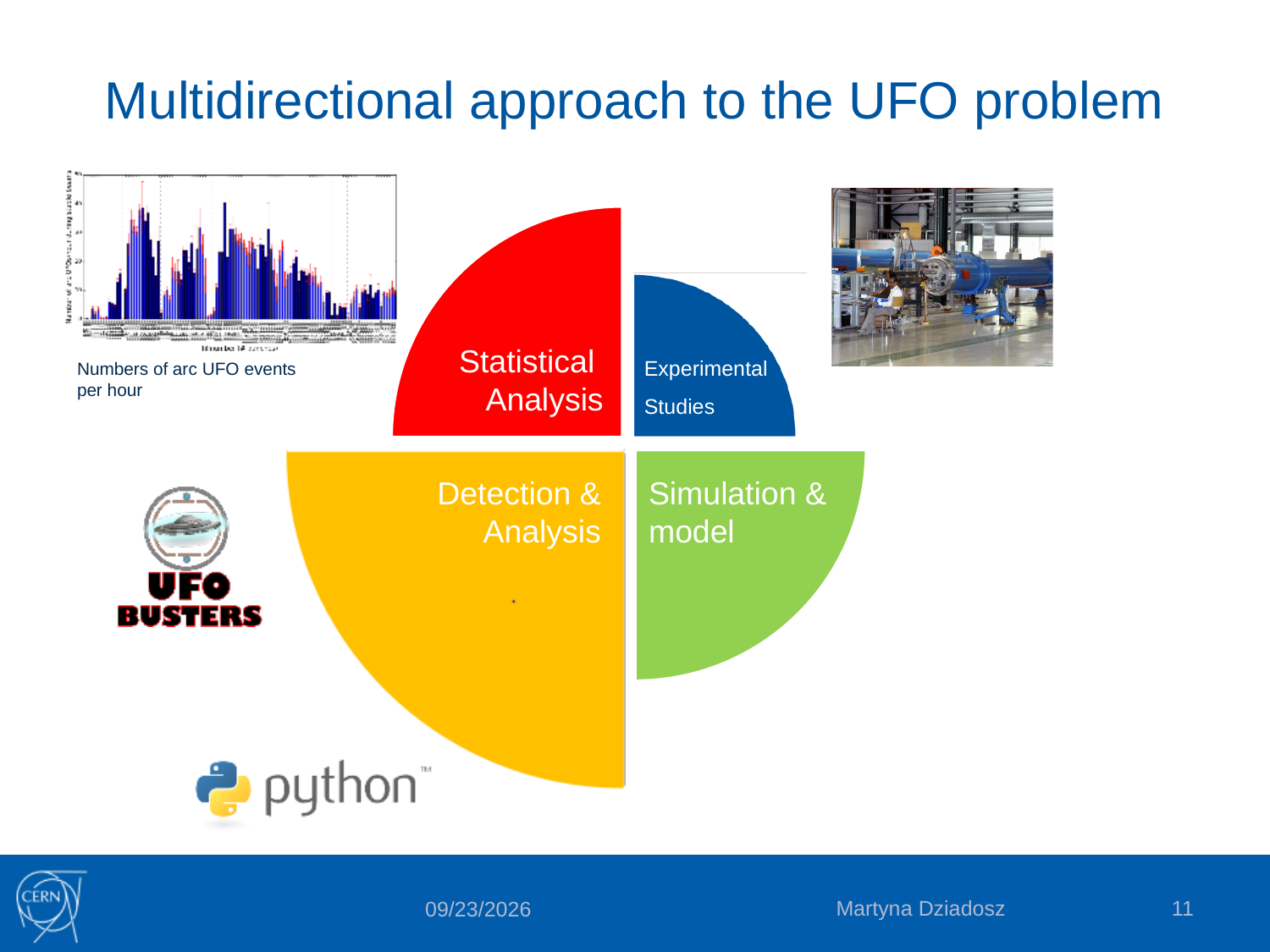
In the quadrant diagram, what colour is the Simulation & model segment? green In the quadrant diagram, what is the label of the red segment? Statistical Analysis What kind of chart is shown in the top-left of the slide? bar chart What two colours are the bars in the top-left bar chart? blue and red What does the caption under the top-left bar chart say it shows? Numbers of arc UFO events per hour How many segments does the four-colour quadrant diagram in the centre of the slide have? 4